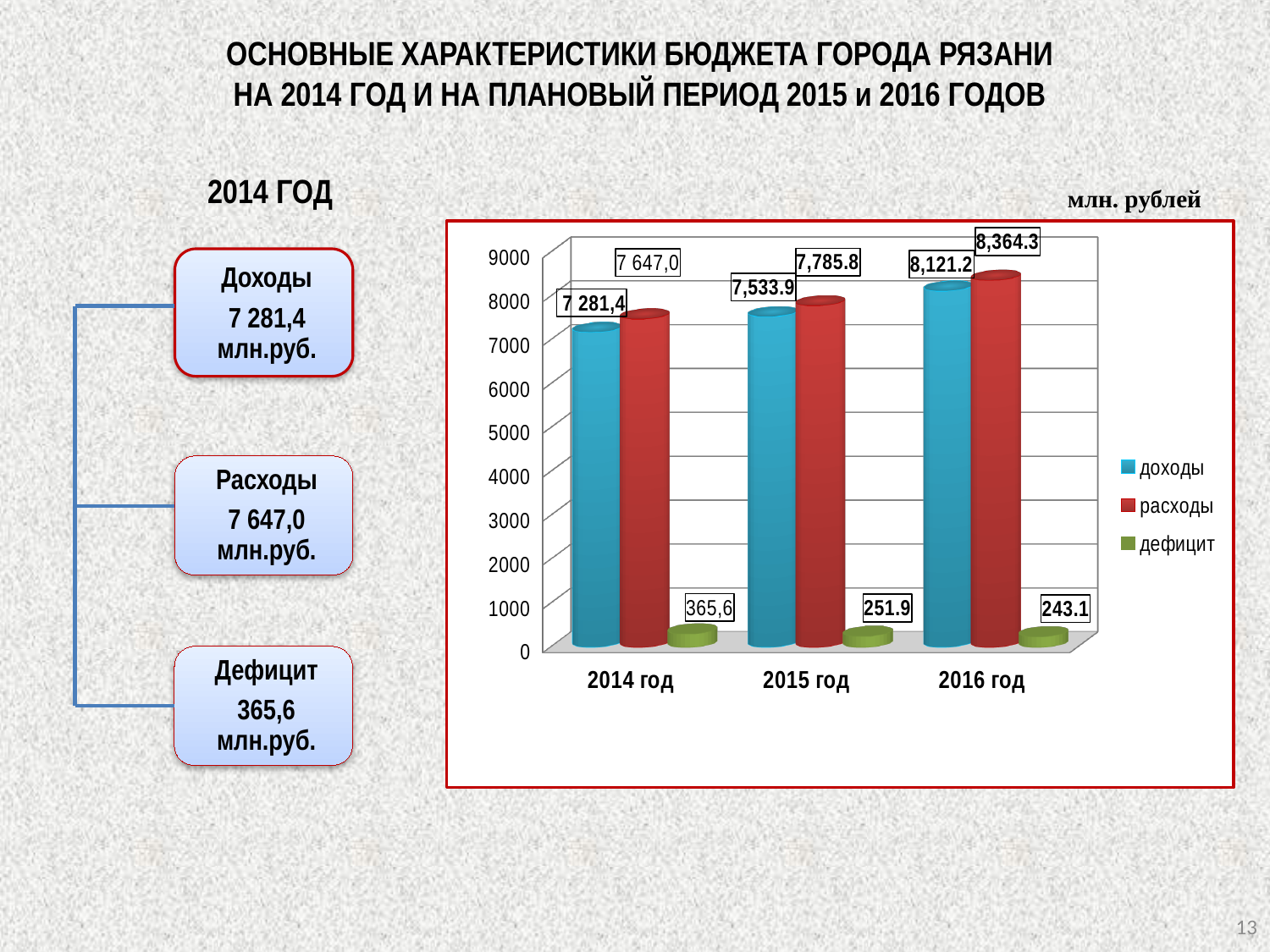
What is the value of доходы for 2014 год? 7 281,4 In which year is расходы the highest? 2016 год What is the difference between расходы and доходы for 2015 год? 251.9 How many year categories are shown on the x axis of the chart? 3 Do the доходы values rise or fall from 2014 год to 2016 год? rise What is the value of расходы for 2015 год? 7,785.8 In which year is дефицит the lowest? 2016 год What type of chart is shown on the slide? bar chart How many series does the chart legend list? 3 What is the value of дефицит for 2016 год? 243.1 Which is larger for 2014 год: доходы or расходы? расходы What is the value of доходы for 2016 год? 8,121.2